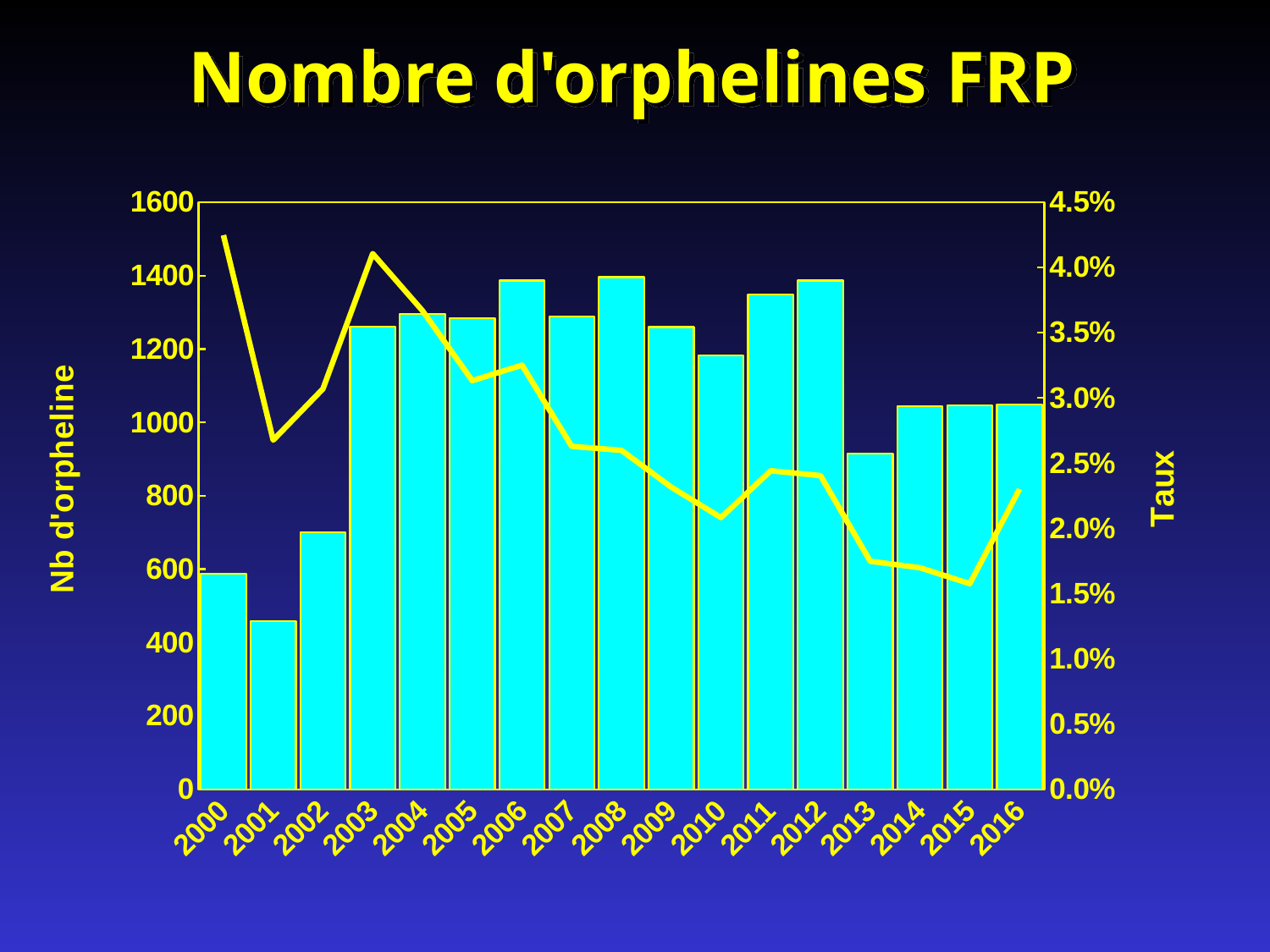
How many years are shown on the x axis of the chart? 17 Is the bar value for 2001 greater or less than 600? less Which year has a taller bar, 2013 or 2014? 2014 What kind of chart is shown on the slide? A bar chart with a line overlay What is the title of the chart? Nombre d'orphelines FRP Is the Taux line value for 2000 greater or less than 4.0%? greater Is the bar value for 2003 greater or less than 1200? greater Which year has the lowest bar (Nb d'orpheline)? 2001 Which year has a taller bar, 2002 or 2003? 2003 Does the Taux line rise or fall from 2003 to 2010? fall